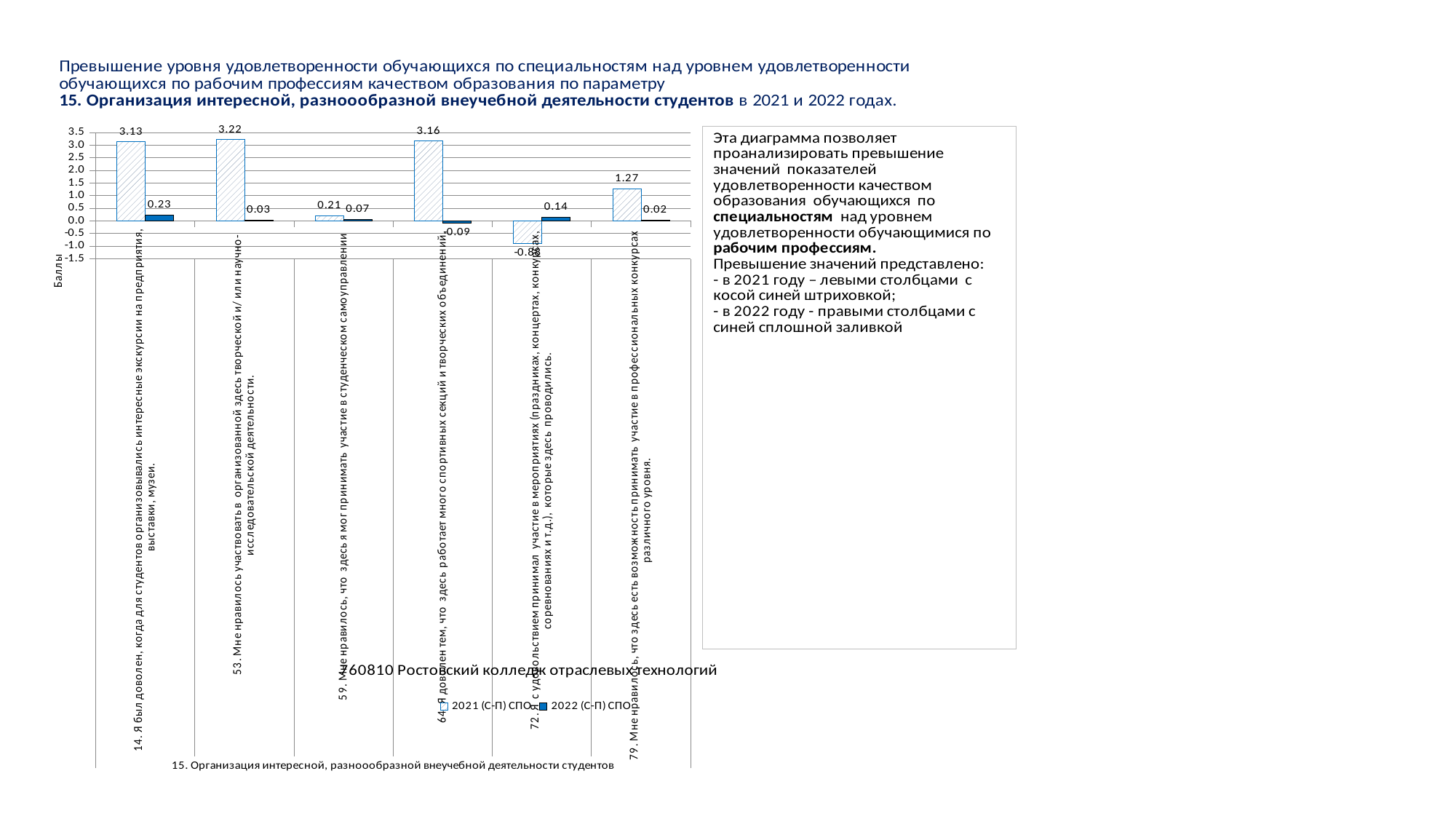
Which statement has the lowest 2022 (С-П) СПО value? 64. Я доволен тем, что здесь работает много спортивных секций и творческих объединений. Which is larger for statement 59: the 2021 (С-П) СПО value or the 2022 (С-П) СПО value? 2021 (С-П) СПО What is the 2022 (С-П) СПО value for statement 64 ("Я доволен тем, что здесь работает много спортивных секций и творческих объединений")? -0.09 How many statements (categories) are shown on the x axis of the chart? 6 What is the 2022 (С-П) СПО value for statement 14 ("Я был доволен, когда для студентов организовывались интересные экскурсии...")? 0.23 Is the 2021 (С-П) СПО value for statement 72 greater or less than 0.0? less Which statement has the highest 2021 (С-П) СПО value? 53. Мне нравилось участвовать в организованной здесь творческой и/или научно-исследовательской деятельности. What is the 2021 (С-П) СПО value for statement 79 ("Мне нравилось, что здесь есть возможность принимать участие в профессиональных конкурсах различного уровня")? 1.27 What is the difference between the 2021 and 2022 (С-П) СПО values for statement 14? 2.90 What type of chart is shown on the slide? Bar chart What is the 2021 (С-П) СПО value for statement 53 ("Мне нравилось участвовать в организованной здесь творческой и/или научно-исследовательской деятельности")? 3.22 How many series does the chart legend list? 2